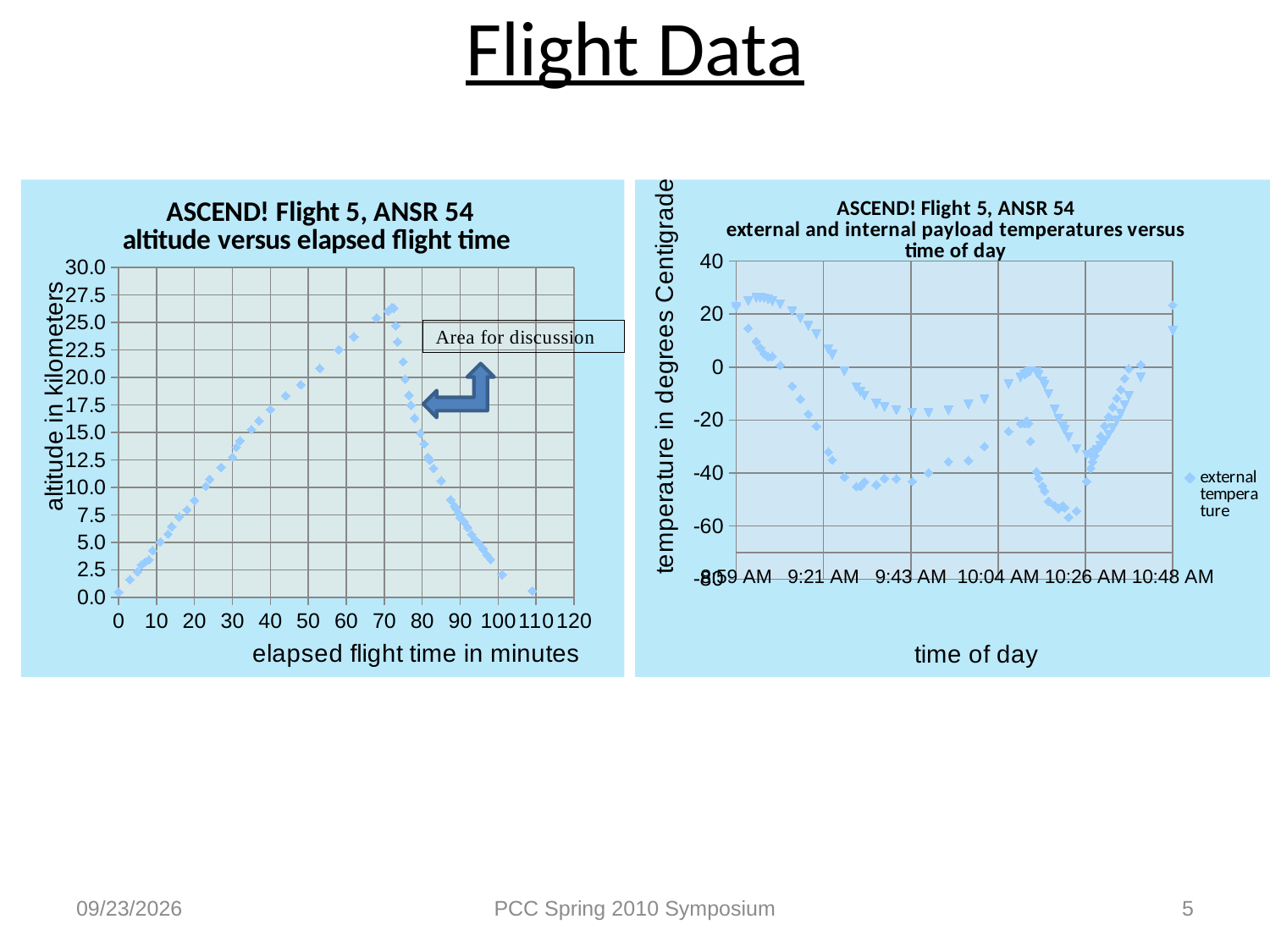
On the left chart, is the altitude at 60 minutes of elapsed flight time greater or less than 20.0 kilometers? greater On the right chart, is the lowest external temperature recorded near 10:26 AM greater or less than -40 degrees Centigrade? less On the left chart, is the altitude at 30 minutes of elapsed flight time greater or less than 10.0 kilometers? greater What kind of chart is the left chart, 'ASCEND! Flight 5, ANSR 54 altitude versus elapsed flight time'? scatter chart What kind of chart is the right chart, 'external and internal payload temperatures versus time of day'? scatter chart On the left chart, what is the label of the x axis? elapsed flight time in minutes On the left chart, does the altitude rise or fall between 80 and 100 minutes of elapsed flight time? fall On the left chart, does the altitude rise or fall between 0 and 60 minutes of elapsed flight time? rise On the right chart, what is the label of the y axis? temperature in degrees Centigrade On the right chart, what is the highest value shown on the y axis? 40